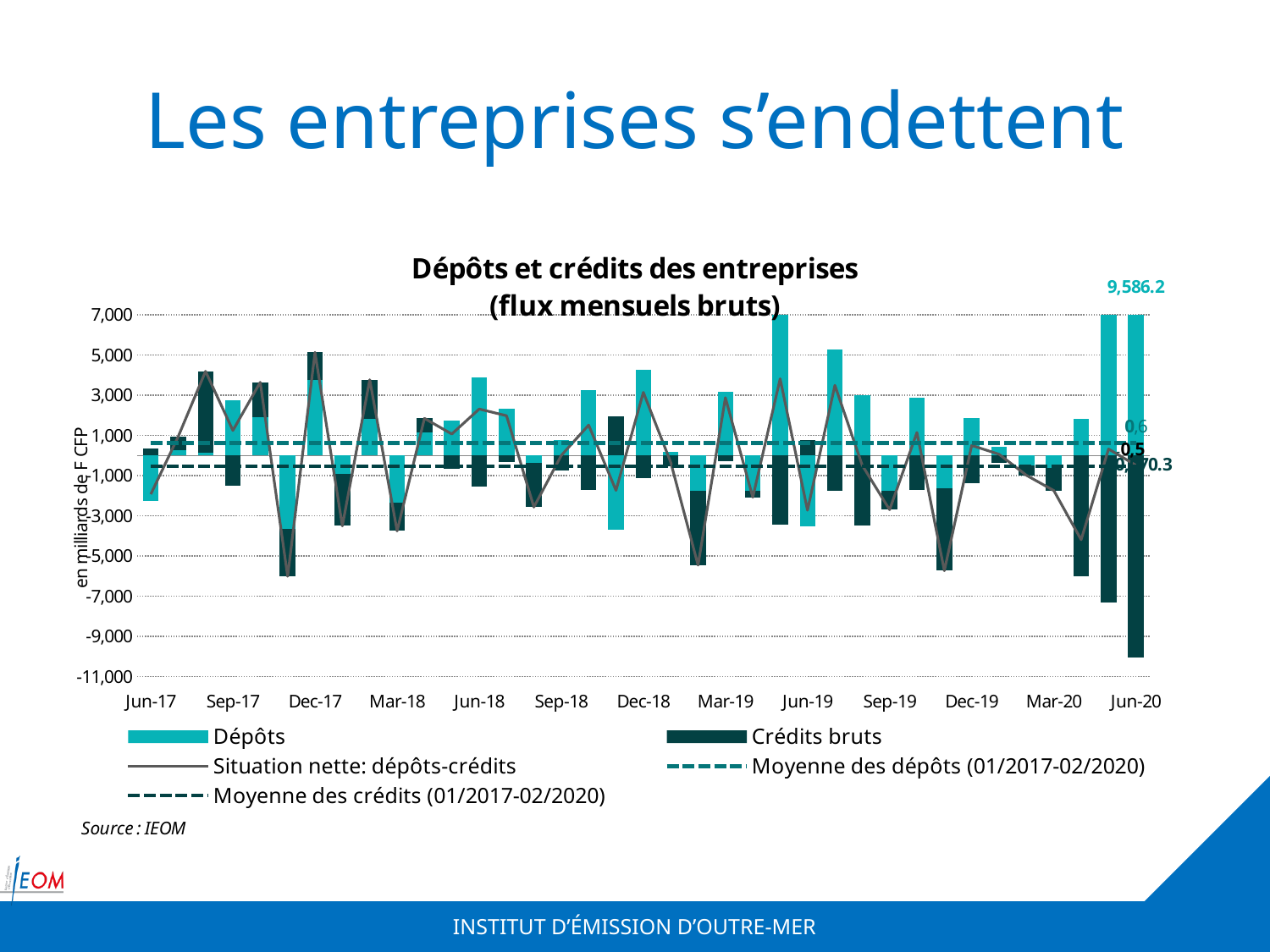
What kind of chart is used to show Dépôts and Crédits bruts? Bar chart (with line series overlaid) Is the Dépôts value for Dec-17 greater or less than 3,000? greater What unit is given on the vertical axis? en milliards de F CFP How many series does the chart legend list? 5 Is the Crédits bruts value for Jun-20 greater or less than -9,000? less What is the title of the chart? Dépôts et crédits des entreprises (flux mensuels bruts) What is the labelled value of Dépôts for Jun-20? 9,586.2 Which month has the highest Dépôts bar? Jun-20 Is the Dépôts value for Jun-20 greater or less than 7,000? greater Which month has the lowest (most negative) Crédits bruts bar? Jun-20 How many month labels are shown on the x axis? 13